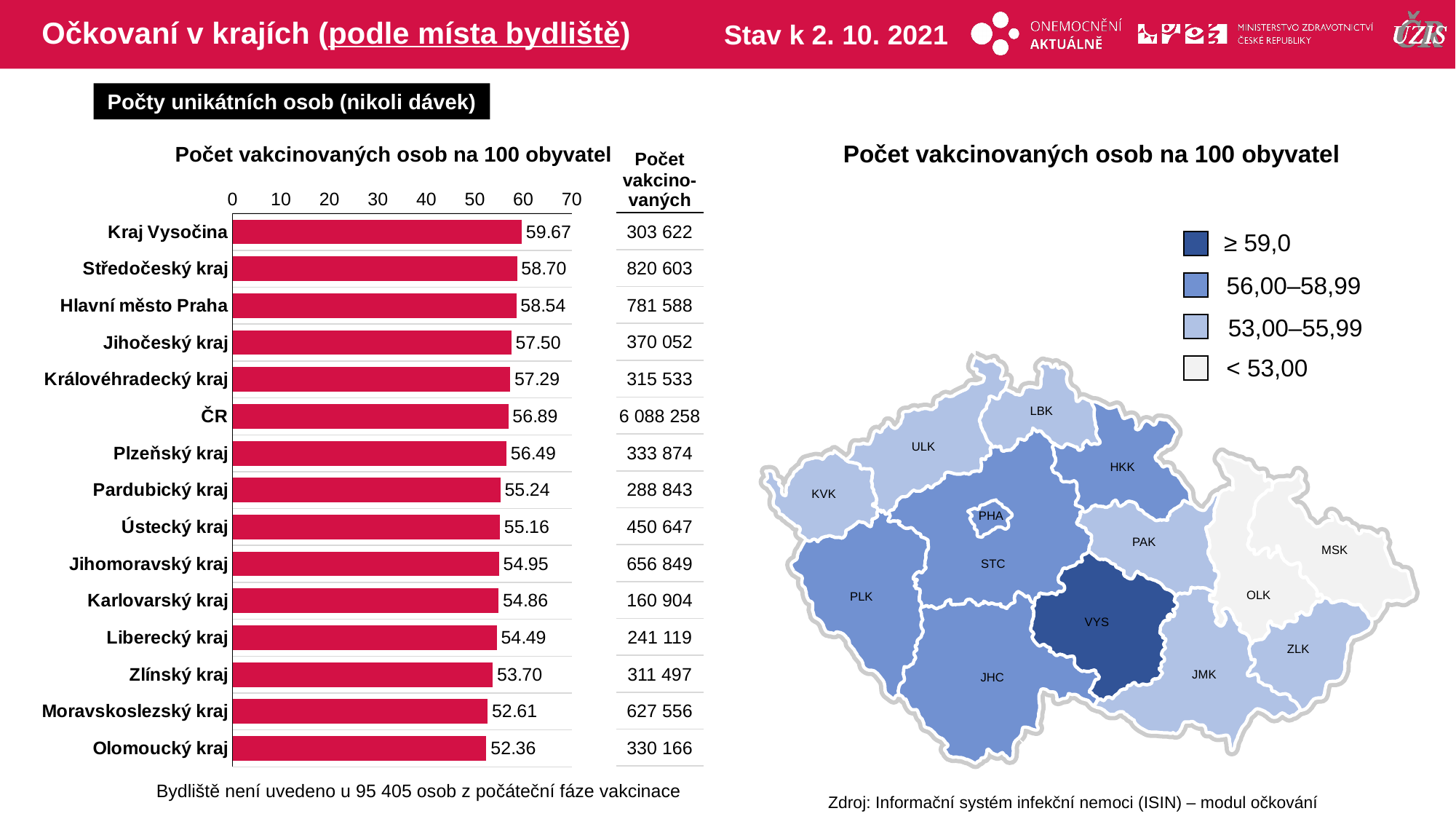
In the bar chart, what is the value for Hlavní město Praha? 58.54 In the bar chart, what is the difference between the values for Kraj Vysočina and Olomoucký kraj? 7.31 In the table next to the bar chart, what is the 'Počet vakcinovaných' value for Středočeský kraj? 820 603 In the bar chart, which region has the lowest number of vaccinated persons per 100 inhabitants? Olomoucký kraj What type of chart is used to show the number of vaccinated persons per 100 inhabitants by region? bar chart In the bar chart, which is larger: the value for Jihočeský kraj or the value for Plzeňský kraj? Jihočeský kraj In the bar chart, what is the value for ČR? 56.89 In the bar chart, which region has the highest number of vaccinated persons per 100 inhabitants? Kraj Vysočina How many bars (categories) are shown in the bar chart? 15 On the map, which region is shaded in the darkest category (≥ 59,0)? VYS In the table next to the bar chart, what is the 'Počet vakcinovaných' value for ČR? 6 088 258 In the bar chart, what is the value for Kraj Vysočina? 59.67